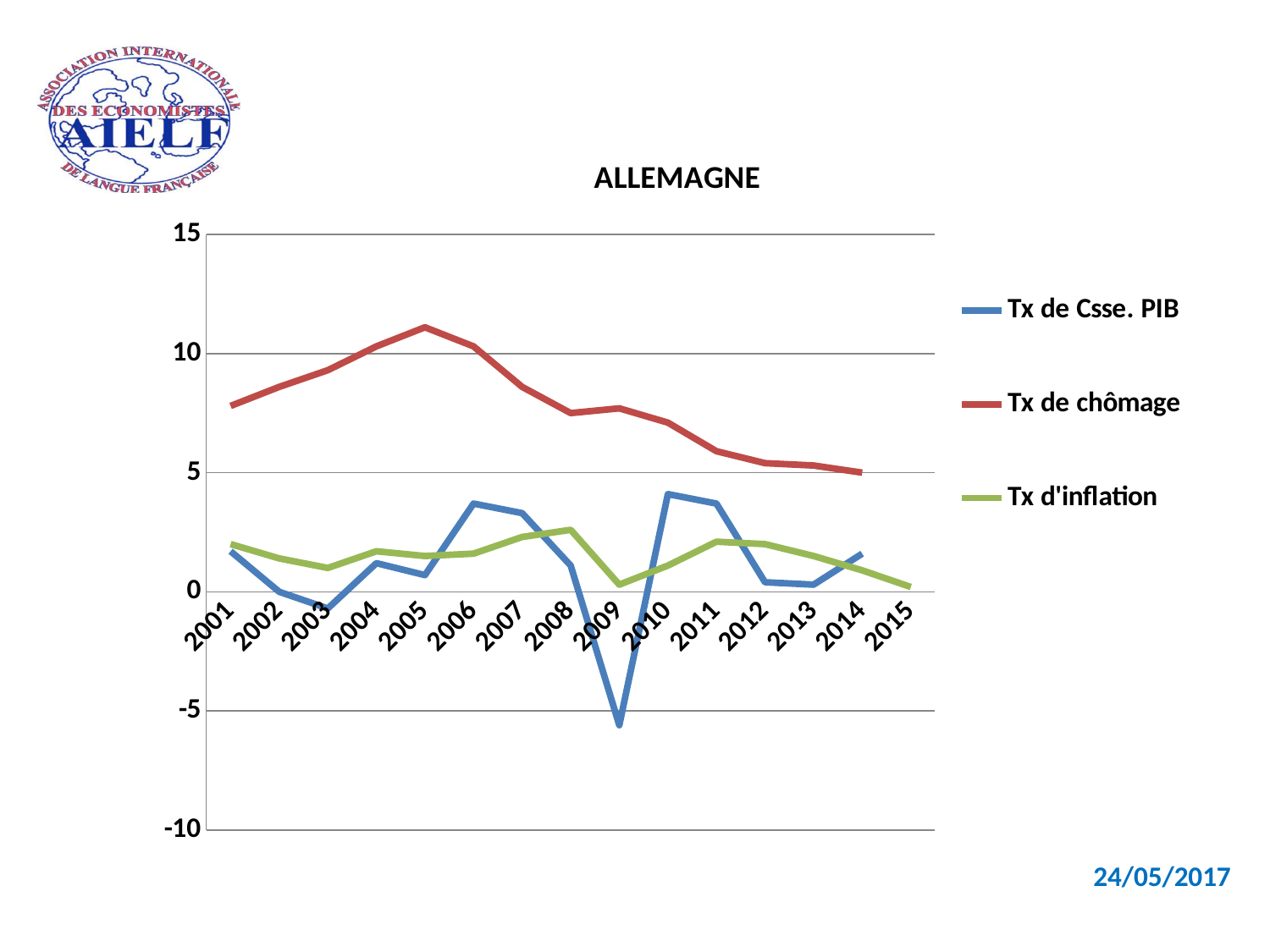
What kind of chart is shown on the slide? line chart Is the value of Tx de chômage in 2005 greater or less than 10? greater Is the value of Tx de Csse. PIB in 2009 greater or less than 0? less How many series does the legend list? 3 Which series is drawn in red? Tx de chômage Does Tx de chômage rise or fall from 2005 to 2014? fall Is the value of Tx d'inflation in 2008 greater or less than 5? less In 2009, which is larger: Tx de chômage or Tx de Csse. PIB? Tx de chômage In which year is Tx de Csse. PIB at its lowest? 2009 In which year is Tx de chômage at its highest? 2005 What is the title of the chart? ALLEMAGNE How many years are shown on the x axis? 15